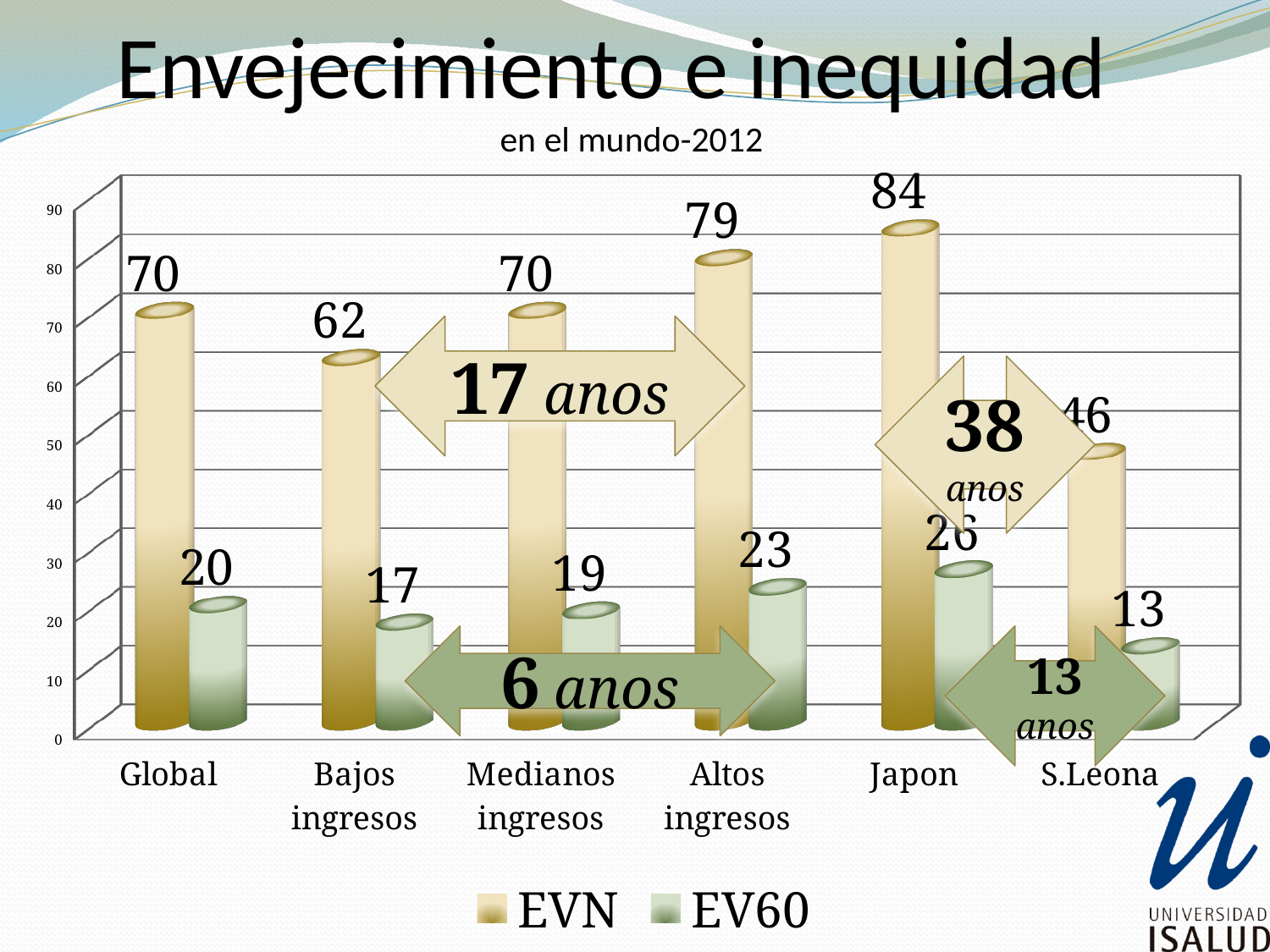
How many series does the legend list? 2 How many categories are shown on the x axis? 6 What is the EVN value for S.Leona? 46 What is the difference between the EVN values for Altos ingresos and Bajos ingresos? 17 What are the names of the two series in the legend? EVN and EV60 Which is larger, the EV60 value for Altos ingresos or for Global? Altos ingresos Which category has the lowest EV60 value? S.Leona Which category has the highest EVN value? Japon What is the EV60 value for Bajos ingresos? 17 What kind of chart is shown on the slide? Bar chart What is the EVN value for Japon? 84 What is the difference between the EV60 values for Japon and S.Leona? 13